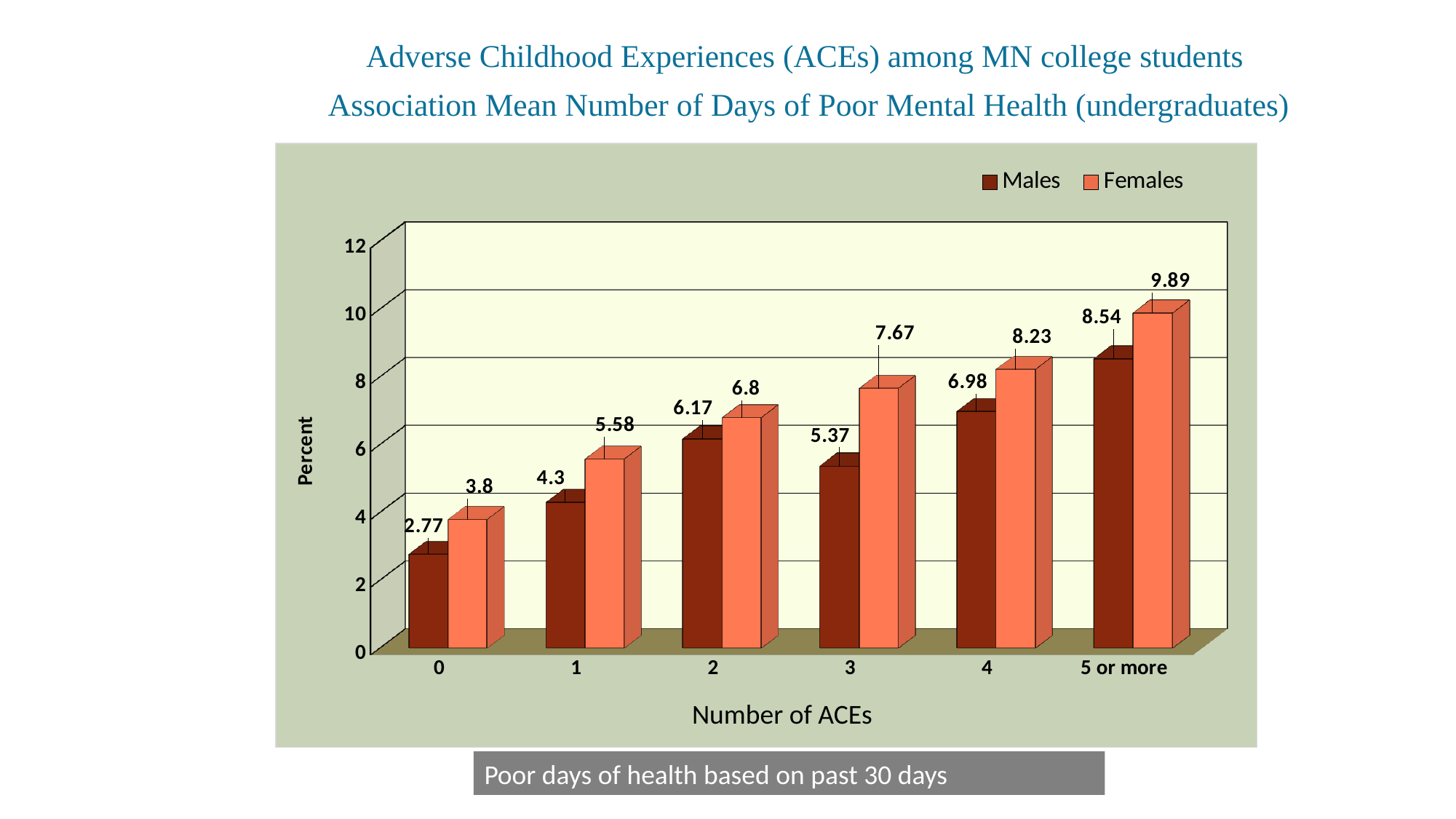
How many categories are shown on the x axis? 6 What is the value for Females at 3 ACEs? 7.67 What is the value for Males at 0 ACEs? 2.77 What is the difference between Females and Males at 1 ACE? 1.28 Which category has the lowest value for Males? 0 What is the label of the x axis? Number of ACEs How many series does the legend list? 2 Do the Females values generally rise or fall as the number of ACEs increases? rise Which category has the highest value for Females? 5 or more What kind of chart is this? bar chart Which is larger: Males at 3 ACEs or Males at 2 ACEs? Males at 2 ACEs What is the value for Males at 5 or more ACEs? 8.54